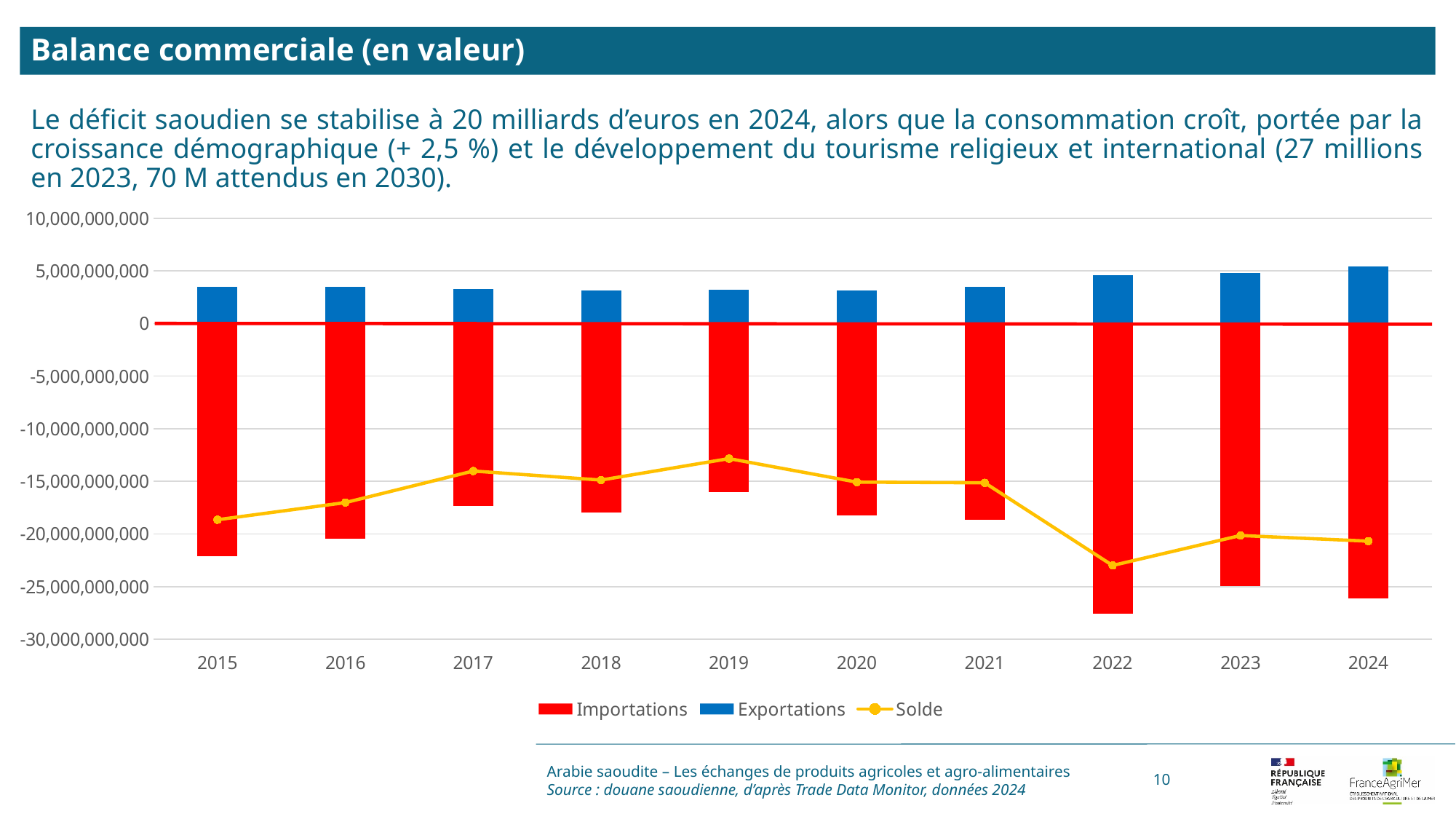
Is the Importations value for 2022 greater or less than -25,000,000,000? less Which year has the lowest Solde value? 2022 Do the Exportations values rise or fall from 2021 to 2024? rise Which is larger, the Exportations value for 2022 or for 2015? 2022 Is the Importations value for 2019 greater or less than -20,000,000,000? greater What kind of chart is shown on the slide? bar chart with a line Is the Exportations value for 2024 greater or less than 5,000,000,000? greater Which year has the highest Exportations value? 2024 How many years are shown on the x axis of the chart? 10 Which year has the highest Solde value? 2019 How many series does the chart legend list? 3 Which year has the lowest (most negative) Importations value? 2022